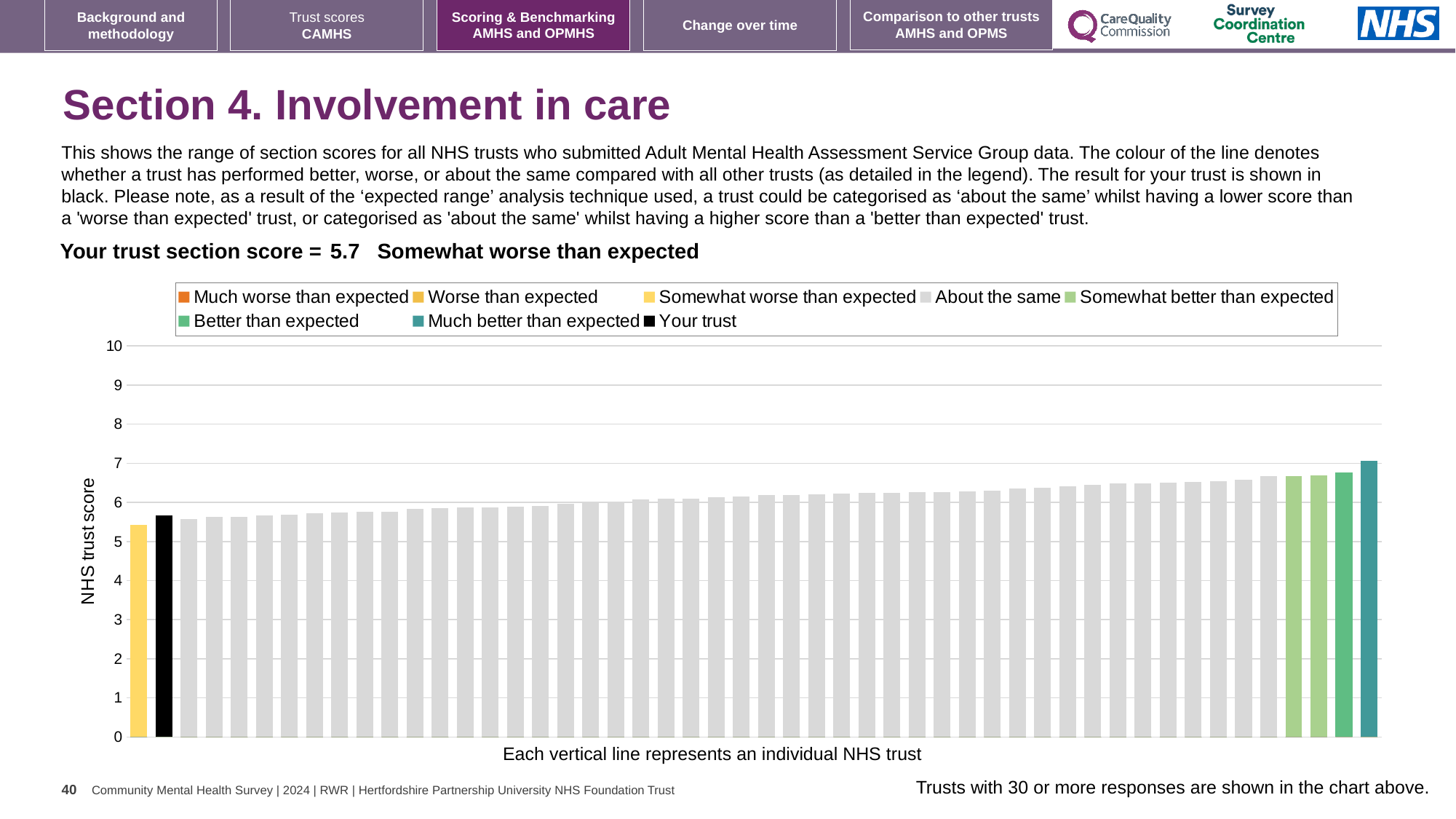
What colour is the bar representing your trust? Black Do the bar values rise or fall from left to right along the x axis? Rise Is the value of the tallest bar (the rightmost, teal bar) greater or less than 6? greater Is the value for your trust greater or less than 5? greater Which category does your trust's section score fall into, according to the slide? Somewhat worse than expected What type of chart is shown on the slide? Bar chart What is the section score for your trust shown on the slide? 5.7 How many entries does the chart legend list? 8 Is the value of the leftmost (yellow) bar greater or less than 6? less What is the label on the vertical axis of the chart? NHS trust score Which is larger: the black bar for your trust or the yellow bar immediately to its left? Your trust